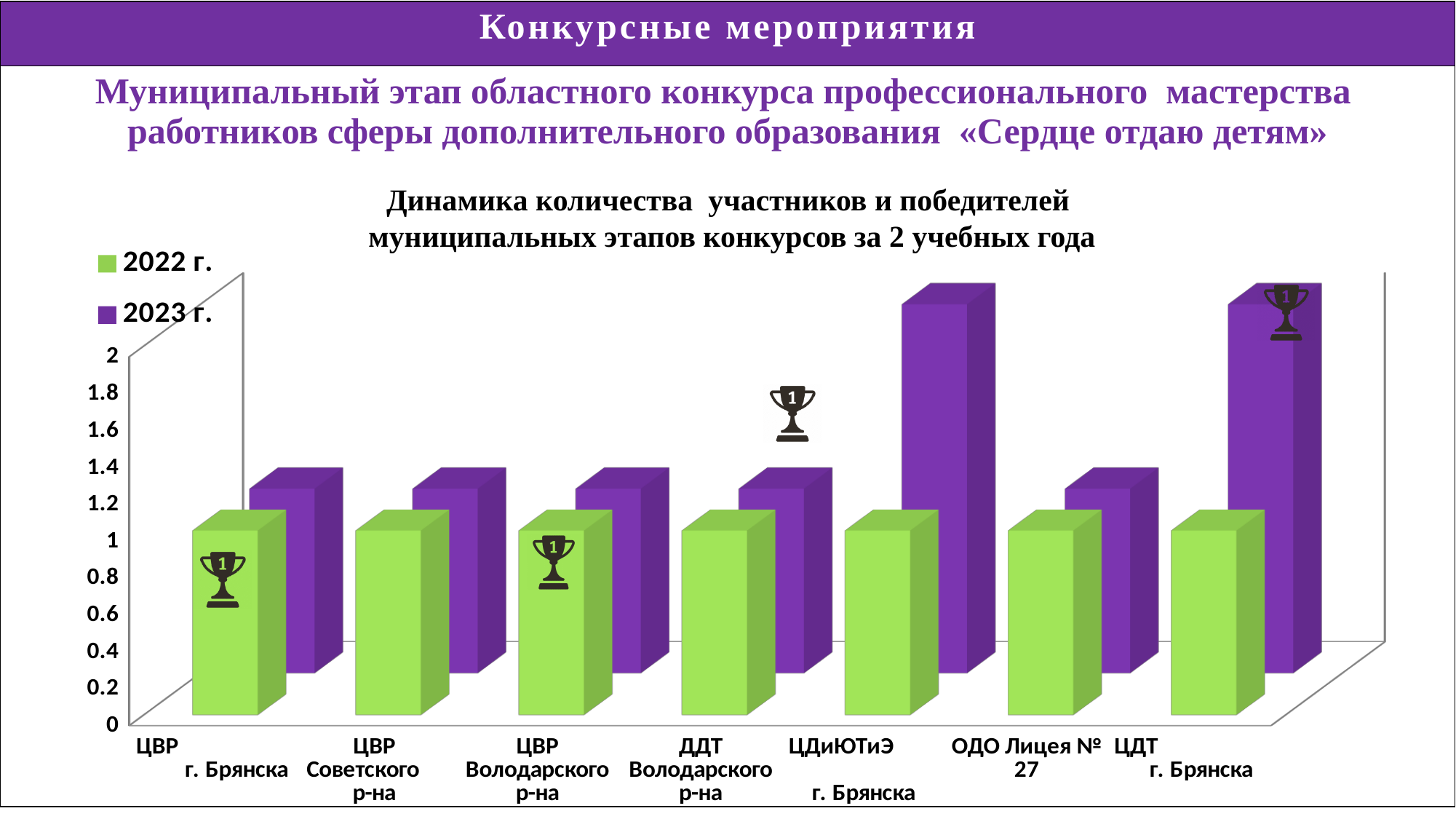
For ЦДТ г. Брянска, which series has the larger value, 2022 г. or 2023 г.? 2023 г. Which two series are listed in the chart legend? 2022 г. and 2023 г. What colour represents the 2022 г. series in the chart? green Is the 2023 г. value for ЦДТ г. Брянска greater or less than 1.6? greater In the 2023 г. series, which is larger: the value for ЦДиЮТиЭ г. Брянска or the value for ЦВР Советского р-на? ЦДиЮТиЭ г. Брянска Is the 2022 г. value for ЦВР г. Брянска greater or less than 1.4? less What kind of chart is shown on the slide? bar chart Is the 2023 г. value for ОДО Лицея № 27 greater or less than 1.6? less In the 2023 г. series, which is larger: the value for ЦДТ г. Брянска or the value for ДДТ Володарского р-на? ЦДТ г. Брянска How many series does the chart legend list? 2 How many categories (institutions) are shown along the x axis of the chart? 7